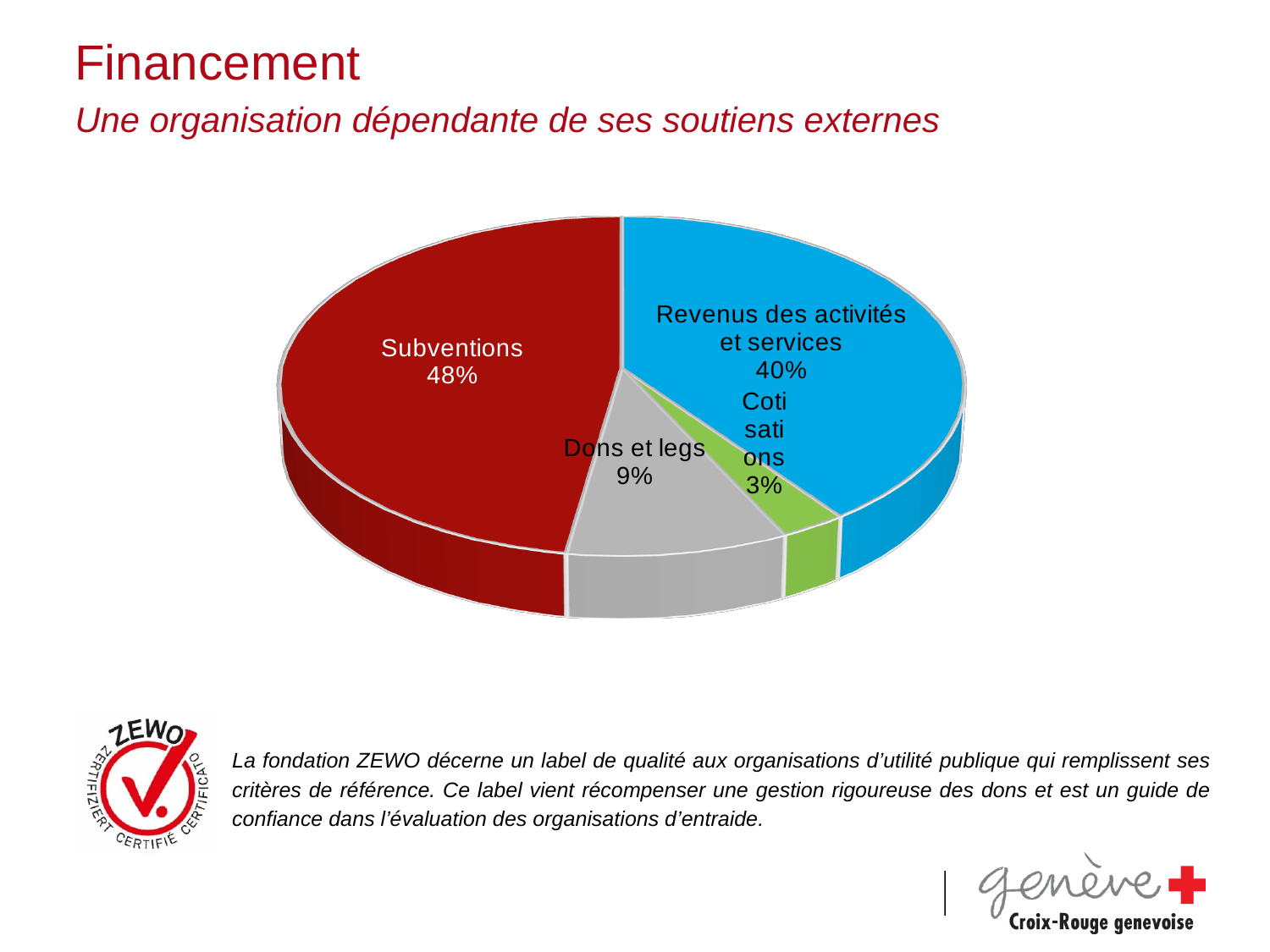
Which category has the largest slice of the pie? Subventions What is the difference in percentage points between Subventions and Revenus des activités et services? 8 What share of the pie does Cotisations represent? 3% What share of the pie does Revenus des activités et services represent? 40% What kind of chart is shown on the slide? Pie chart What share of the pie does Dons et legs represent? 9% Which is larger, the share for Dons et legs or the share for Cotisations? Dons et legs Which category has the smallest slice of the pie? Cotisations What share of the pie does Subventions represent? 48% What is the difference in percentage points between Dons et legs and Cotisations? 6 What colour is the Subventions slice? Red How many categories are shown in the pie chart? 4